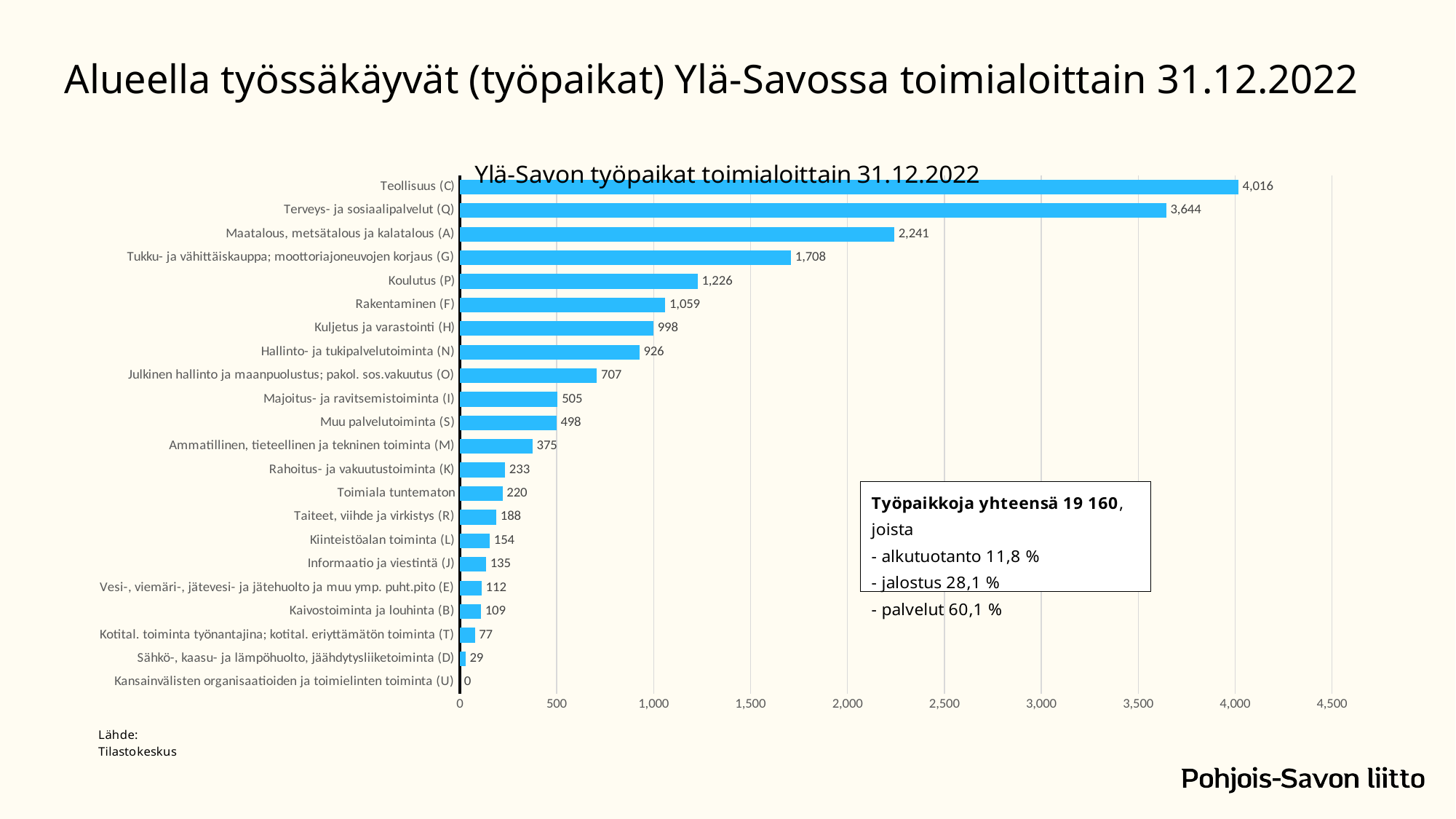
What is the value for Teollisuus (C)? 4,016 What is the value for Koulutus (P)? 1,226 Which is larger, Rakentaminen (F) or Kuljetus ja varastointi (H)? Rakentaminen (F) What is the difference between Majoitus- ja ravitsemistoiminta (I) and Muu palvelutoiminta (S)? 7 Is the value for Maatalous, metsätalous ja kalatalous (A) greater or less than 2,000? greater Which category has the lowest value? Kansainvälisten organisaatioiden ja toimielinten toiminta (U) Which category has the highest value? Teollisuus (C) What is the difference between Teollisuus (C) and Terveys- ja sosiaalipalvelut (Q)? 372 What is the title of the chart? Ylä-Savon työpaikat toimialoittain 31.12.2022 What kind of chart is shown on the slide? bar chart What is the value for Kaivostoiminta ja louhinta (B)? 109 How many categories are shown in the chart? 22